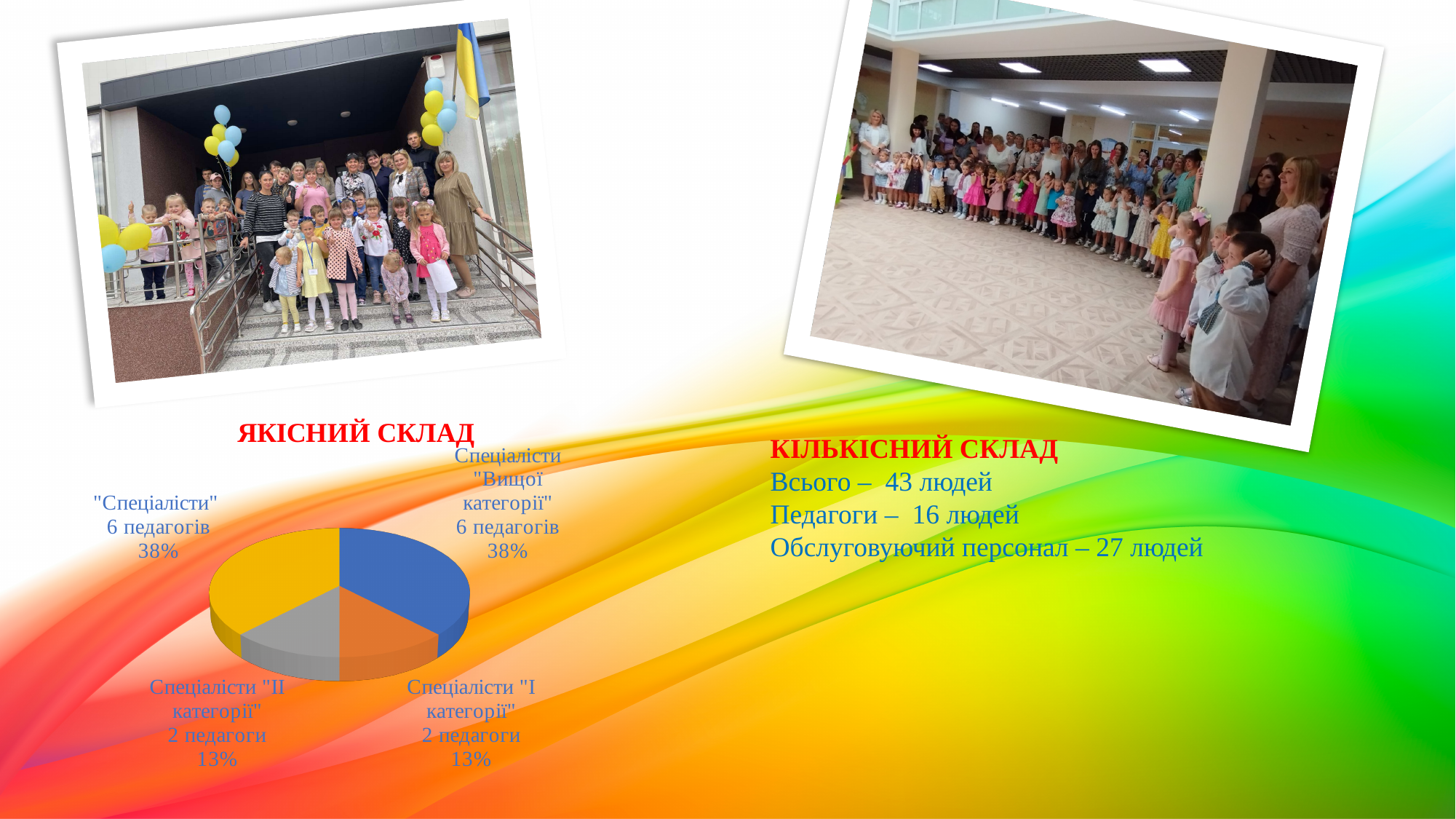
What colour is the "Спеціалісти "Вищої категорії"" slice in the pie chart? blue What kind of chart is shown under the heading "ЯКІСНИЙ СКЛАД"? pie chart How many педагоги are in the "Спеціалісти "Вищої категорії"" slice of the pie chart? 6 педагогів What percentage share does the "Спеціалісти "ІІ категорії"" slice have in the pie chart? 13% What percentage share does the "Спеціалісти" slice have in the pie chart? 38% What is the total number of педагоги across all four slices of the pie chart? 16 How many педагоги are in the "Спеціалісти "І категорії"" slice of the pie chart? 2 педагоги What is the title shown above the pie chart? ЯКІСНИЙ СКЛАД Which slice is larger in the pie chart: "Спеціалісти" or "Спеціалісти "І категорії""? "Спеціалісти" What is the difference in percentage points between the "Спеціалісти" slice and the "Спеціалісти "І категорії"" slice? 25 How many slices does the pie chart have? 4 What is the difference in number of педагоги between the "Спеціалісти "Вищої категорії"" slice and the "Спеціалісти "ІІ категорії"" slice? 4